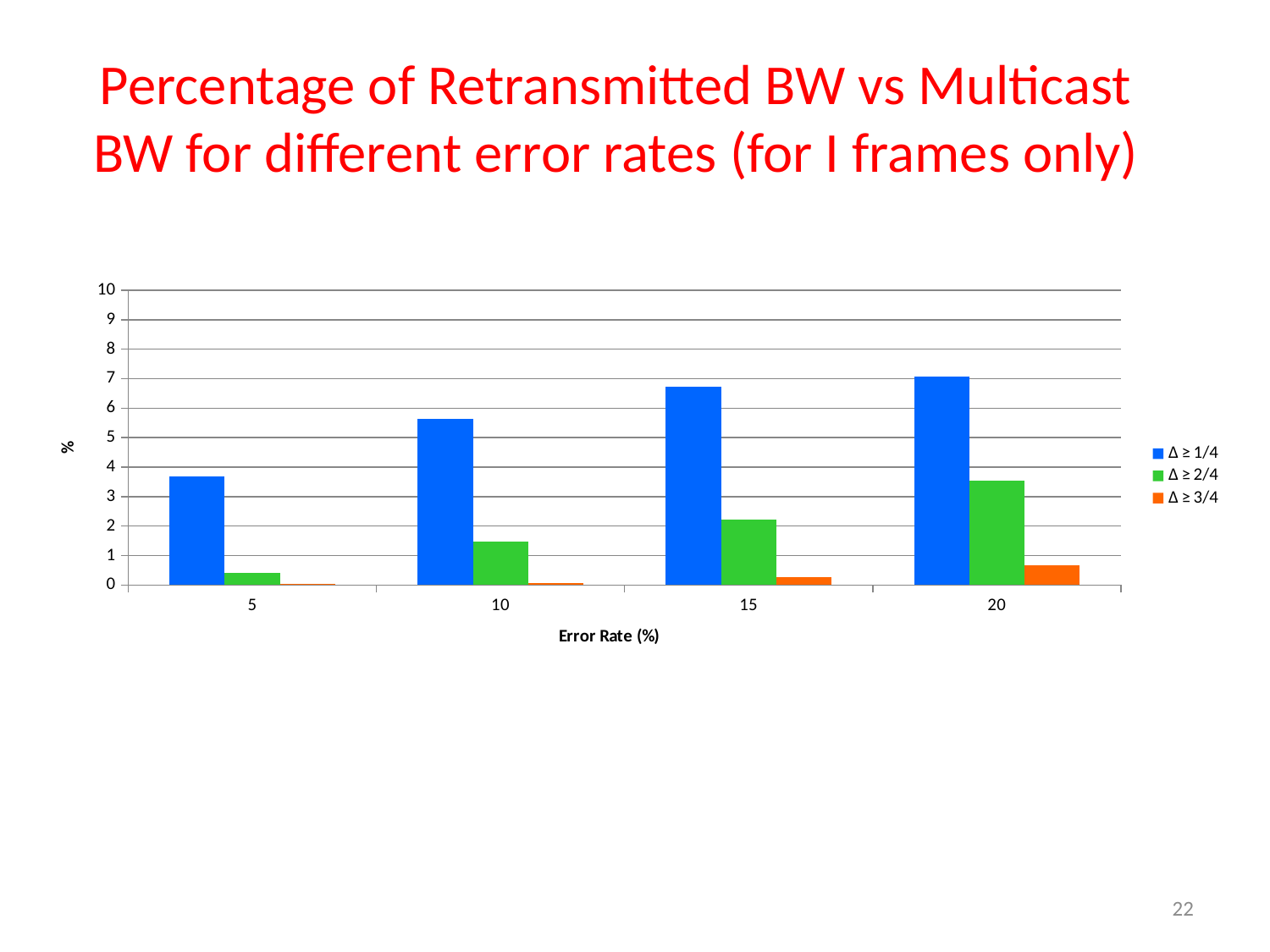
Is the value for Δ ≥ 1/4 at an error rate of 20% greater or less than 8? less Which is larger: Δ ≥ 1/4 at an error rate of 10% or Δ ≥ 2/4 at an error rate of 20%? Δ ≥ 1/4 at 10% Is the value for Δ ≥ 1/4 at an error rate of 5% greater or less than 3? greater At which error rate is the Δ ≥ 1/4 series highest? 20 What kind of chart is shown on the slide? bar chart How many error rate categories are shown on the x axis? 4 Is the value for Δ ≥ 2/4 at an error rate of 10% greater or less than 2? less How many series does the legend list? 3 At which error rate is the Δ ≥ 2/4 series lowest? 5 Do the values for Δ ≥ 1/4 rise or fall as the error rate increases? rise